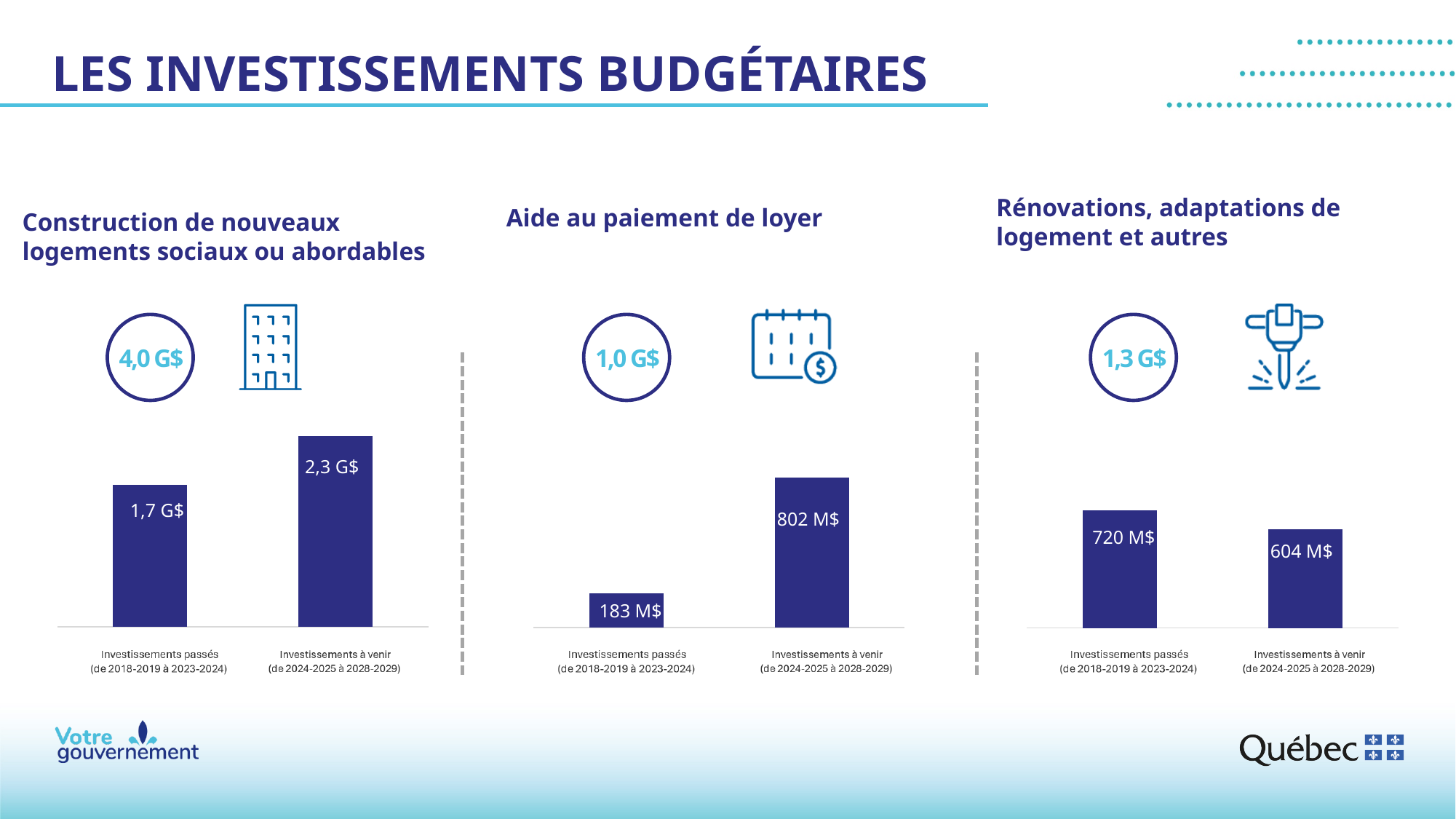
In the 'Rénovations, adaptations de logement et autres' chart, do the values rise or fall from 'Investissements passés' to 'Investissements à venir'? fall In the 'Rénovations, adaptations de logement et autres' chart, what is the value for 'Investissements à venir (de 2024-2025 à 2028-2029)'? 604 M$ In the 'Construction de nouveaux logements sociaux ou abordables' chart, what is the value for 'Investissements à venir (de 2024-2025 à 2028-2029)'? 2,3 G$ In the 'Construction de nouveaux logements sociaux ou abordables' chart, what is the value for 'Investissements passés (de 2018-2019 à 2023-2024)'? 1,7 G$ What kind of chart is used in the 'Aide au paiement de loyer' section? bar chart In the 'Rénovations, adaptations de logement et autres' chart, what is the value for 'Investissements passés (de 2018-2019 à 2023-2024)'? 720 M$ In the 'Rénovations, adaptations de logement et autres' chart, which category has the higher value? Investissements passés (de 2018-2019 à 2023-2024) In the 'Aide au paiement de loyer' chart, what is the value for 'Investissements à venir (de 2024-2025 à 2028-2029)'? 802 M$ In the 'Aide au paiement de loyer' chart, which category has the lowest value? Investissements passés (de 2018-2019 à 2023-2024) In the 'Construction de nouveaux logements sociaux ou abordables' chart, what is the difference between 'Investissements à venir' and 'Investissements passés'? 0,6 G$ In the 'Aide au paiement de loyer' chart, what is the value for 'Investissements passés (de 2018-2019 à 2023-2024)'? 183 M$ In the 'Aide au paiement de loyer' chart, what is the difference between 'Investissements à venir' and 'Investissements passés'? 619 M$